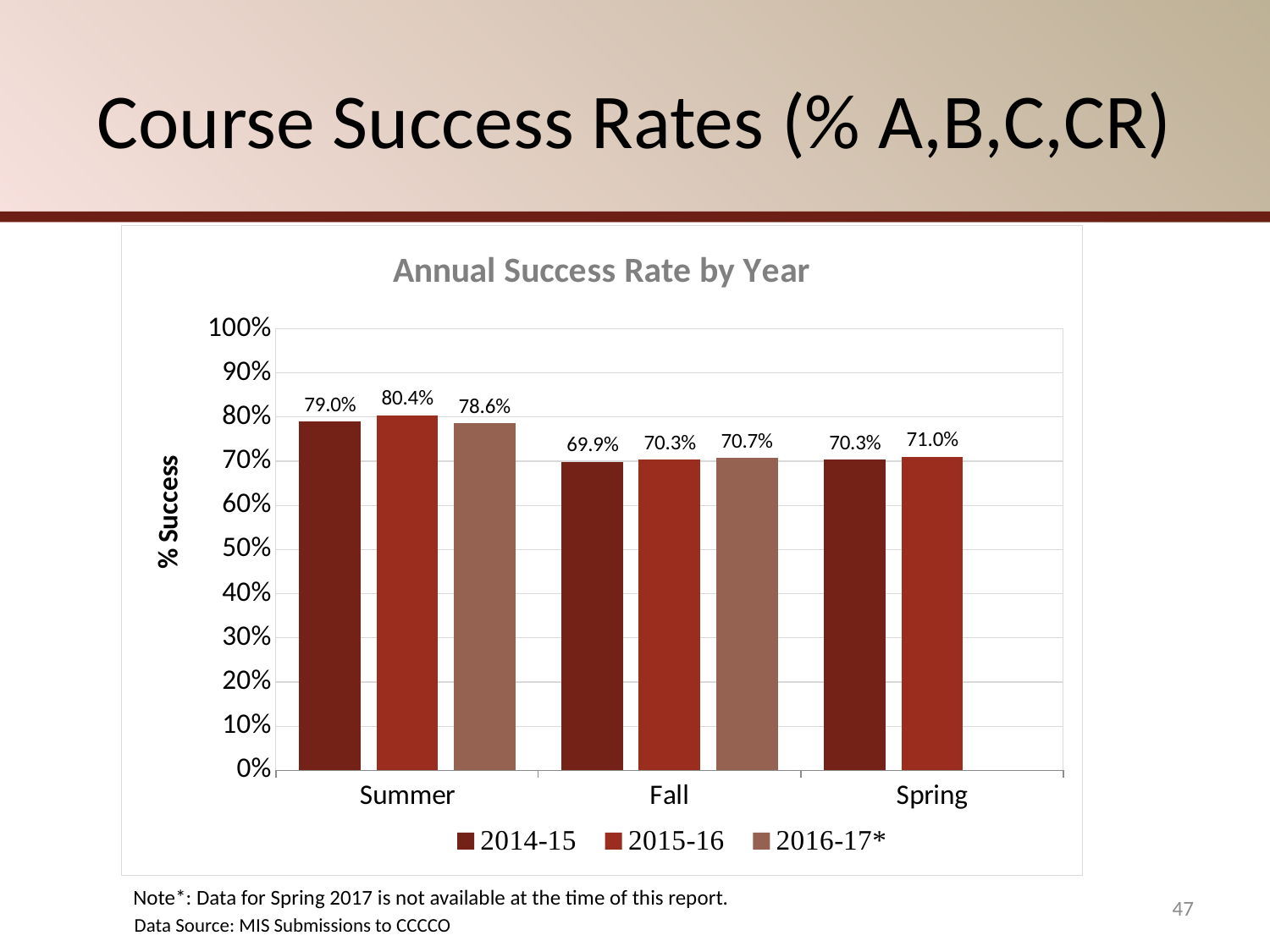
Which term has the lowest success rate in 2015-16? Fall What is the success rate for Summer in 2015-16? 80.4% What is the difference between the Summer and Fall success rates in 2015-16? 10.1% Which term has the highest success rate in 2014-15? Summer What is the success rate for Fall in 2014-15? 69.9% What kind of chart is shown? Bar chart How many series does the legend list? 3 How many terms are shown on the x axis? 3 What is the title of the chart? Annual Success Rate by Year Which is larger, the Fall success rate in 2016-17* or the Spring success rate in 2014-15? Fall 2016-17* What is the success rate for Spring in 2015-16? 71.0% What is the success rate for Summer in 2016-17*? 78.6%